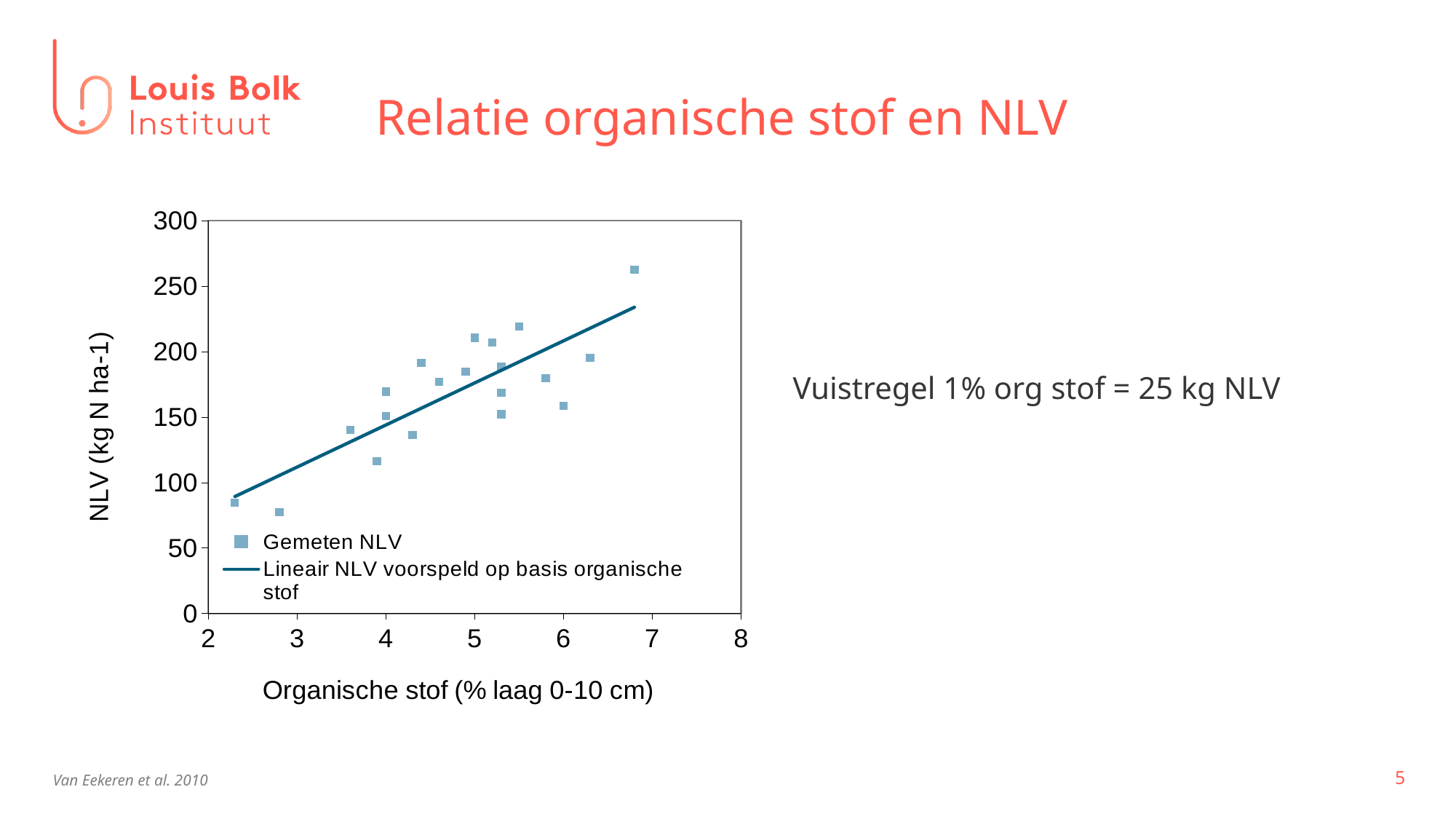
Is the highest 'Gemeten NLV' point on the chart greater or less than 250? greater Is the 'Gemeten NLV' value for the point at about 6.8% organische stof greater or less than 250? greater Is the 'Gemeten NLV' value for the point at about 2.8% organische stof greater or less than 100? less What is the label of the y axis of the chart? NLV (kg N ha-1) Does the fitted line 'Lineair NLV voorspeld op basis organische stof' rise or fall as organische stof increases along the x axis? rise What kind of chart is shown on the slide? scatter chart Which has the higher measured NLV: the point at about 6.8% organische stof or the point at about 2.3% organische stof? the point at about 6.8% What are the two entries in the chart legend? Gemeten NLV; Lineair NLV voorspeld op basis organische stof How many series does the chart legend list? 2